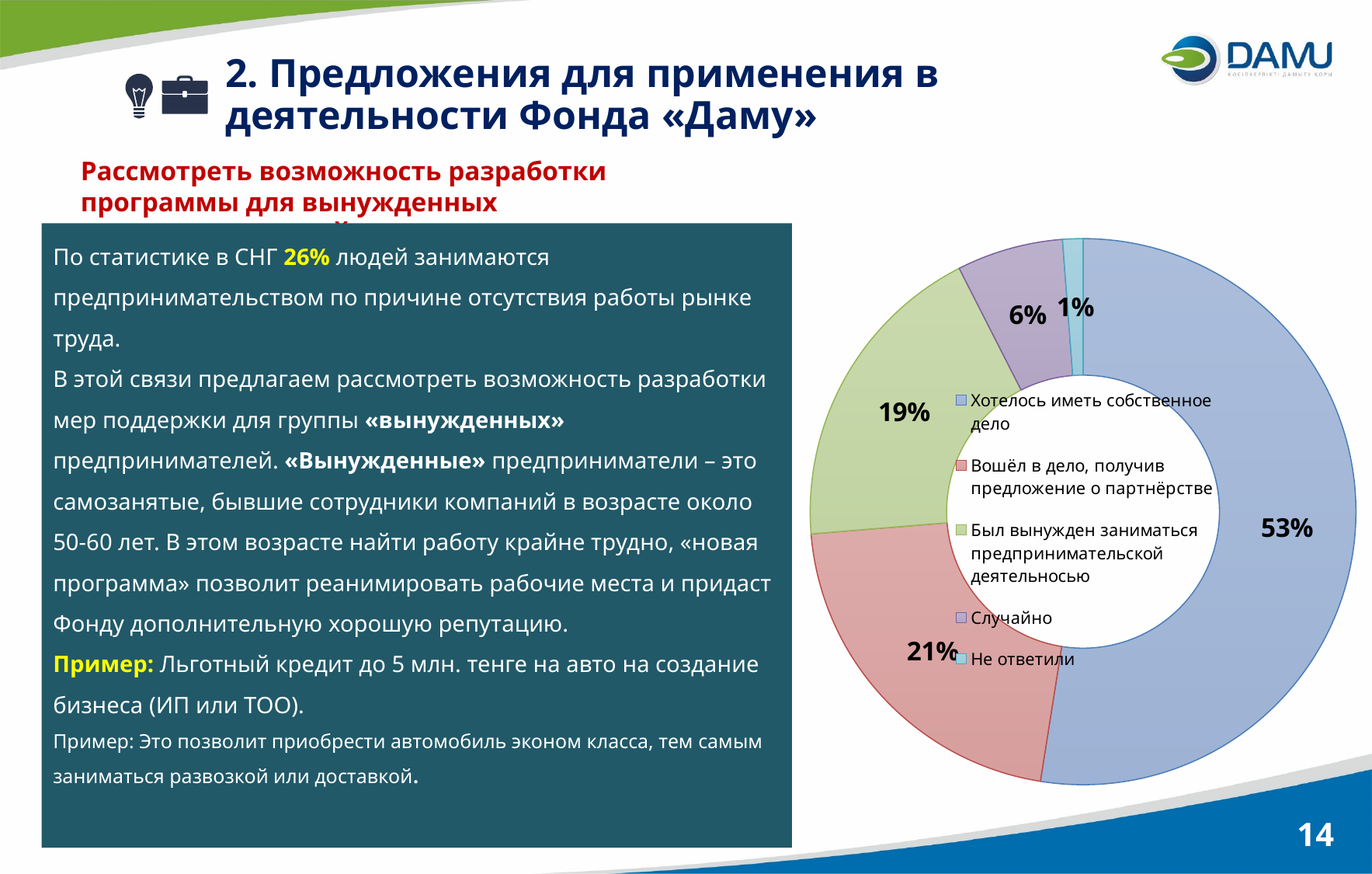
What share of respondents answered «Не ответили»? 1% Which category has the smallest share in the chart? Не ответили Which category has the largest share in the chart? Хотелось иметь собственное дело What share of respondents answered «Был вынужден заниматься предпринимательской деятельносью»? 19% What share of respondents answered «Случайно»? 6% What share of respondents answered «Вошёл в дело, получив предложение о партнёрстве»? 21% What is the difference in percentage points between «Хотелось иметь собственное дело» and «Вошёл в дело, получив предложение о партнёрстве»? 32 What share of respondents answered «Хотелось иметь собственное дело»? 53% How many categories does the chart show? 5 What kind of chart is shown on the slide? Doughnut (pie) chart Which is larger: the share for «Случайно» or the share for «Был вынужден заниматься предпринимательской деятельносью»? Был вынужден заниматься предпринимательской деятельносью What colour is the slice for «Был вынужден заниматься предпринимательской деятельносью»? Green